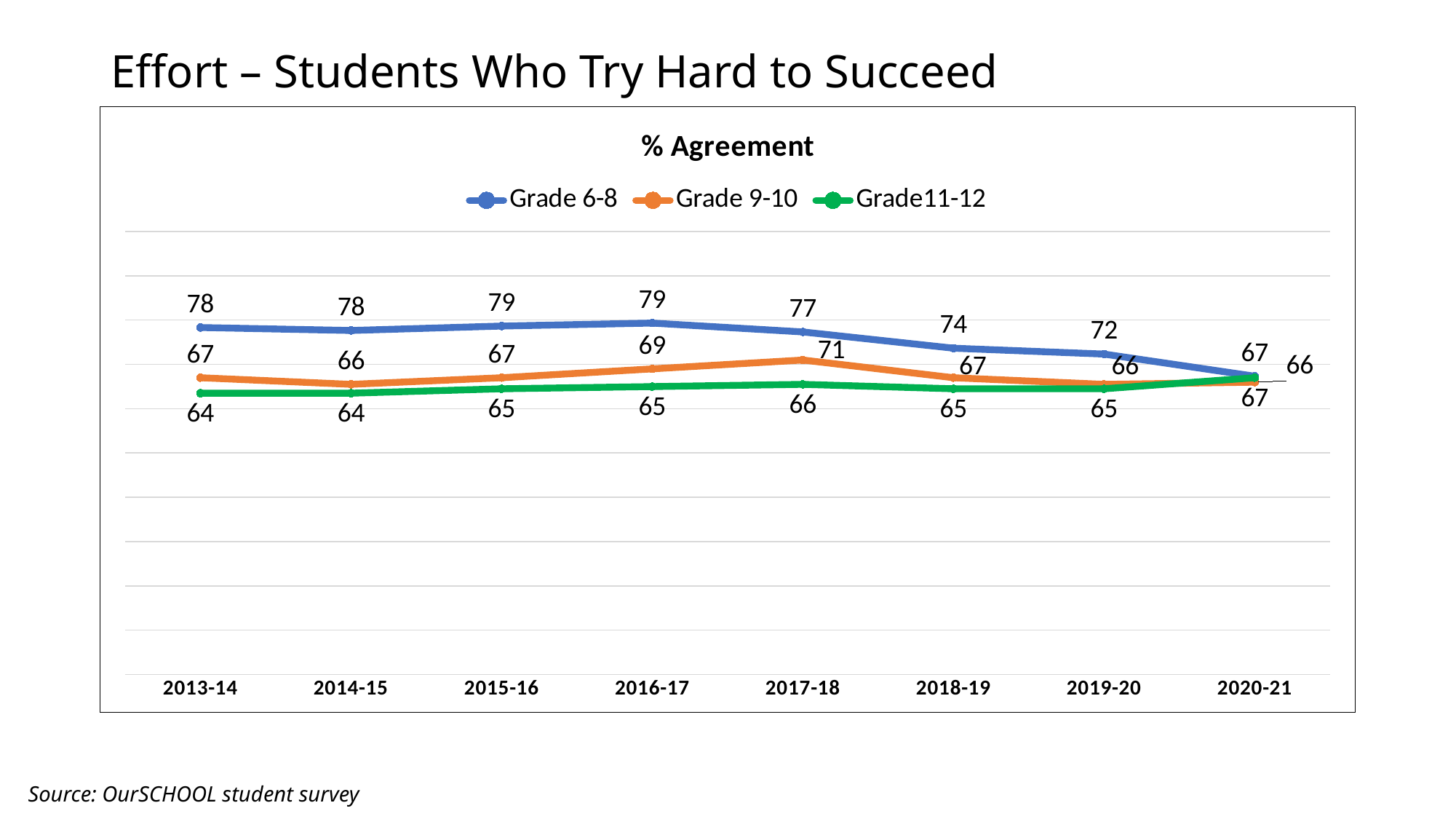
In which year does Grade 9-10 reach its highest % Agreement? 2017-18 Which series has the higher value in 2018-19, Grade 6-8 or Grade 9-10? Grade 6-8 What type of chart is shown on the slide? line chart Does the Grade 6-8 line rise or fall from 2016-17 to 2019-20? fall How many series does the legend list? 3 What is the % Agreement for Grade 9-10 in 2017-18? 71 What is the % Agreement for Grade 6-8 in 2016-17? 79 What is the % Agreement for Grade 6-8 in 2019-20? 72 How many school years are shown on the x axis? 8 What is the % Agreement for Grade11-12 in 2013-14? 64 What is the title shown inside the chart area? % Agreement What is the difference between Grade 6-8 and Grade11-12 in 2013-14? 14